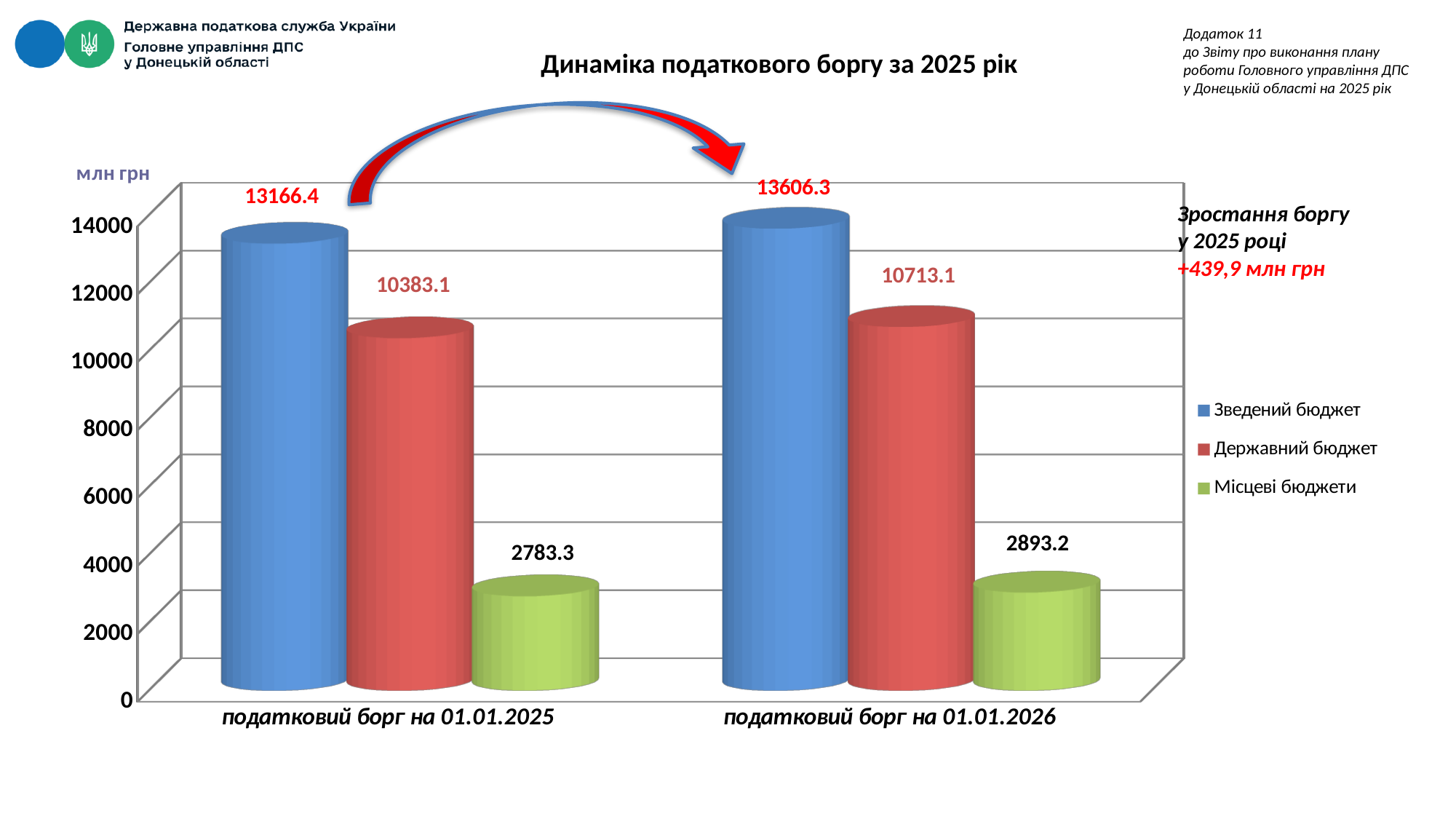
What is the difference between the Державний бюджет values for податковий борг на 01.01.2026 and податковий борг на 01.01.2025? 330.0 Which series has the highest value for податковий борг на 01.01.2025? Зведений бюджет What is the title of the chart? Динаміка податкового боргу за 2025 рік How many series does the legend list? 3 What is the value for Зведений бюджет for податковий борг на 01.01.2026? 13606.3 By how much did the value for Зведений бюджет change from податковий борг на 01.01.2025 to податковий борг на 01.01.2026? 439.9 What is the value for Зведений бюджет for податковий борг на 01.01.2025? 13166.4 What is the value for Державний бюджет for податковий борг на 01.01.2026? 10713.1 Which series has the lowest value for податковий борг на 01.01.2026? Місцеві бюджети What is the value for Місцеві бюджети for податковий борг на 01.01.2025? 2783.3 What kind of chart is shown on the slide? Bar chart Which is larger: Місцеві бюджети for податковий борг на 01.01.2025 or for податковий борг на 01.01.2026? податковий борг на 01.01.2026